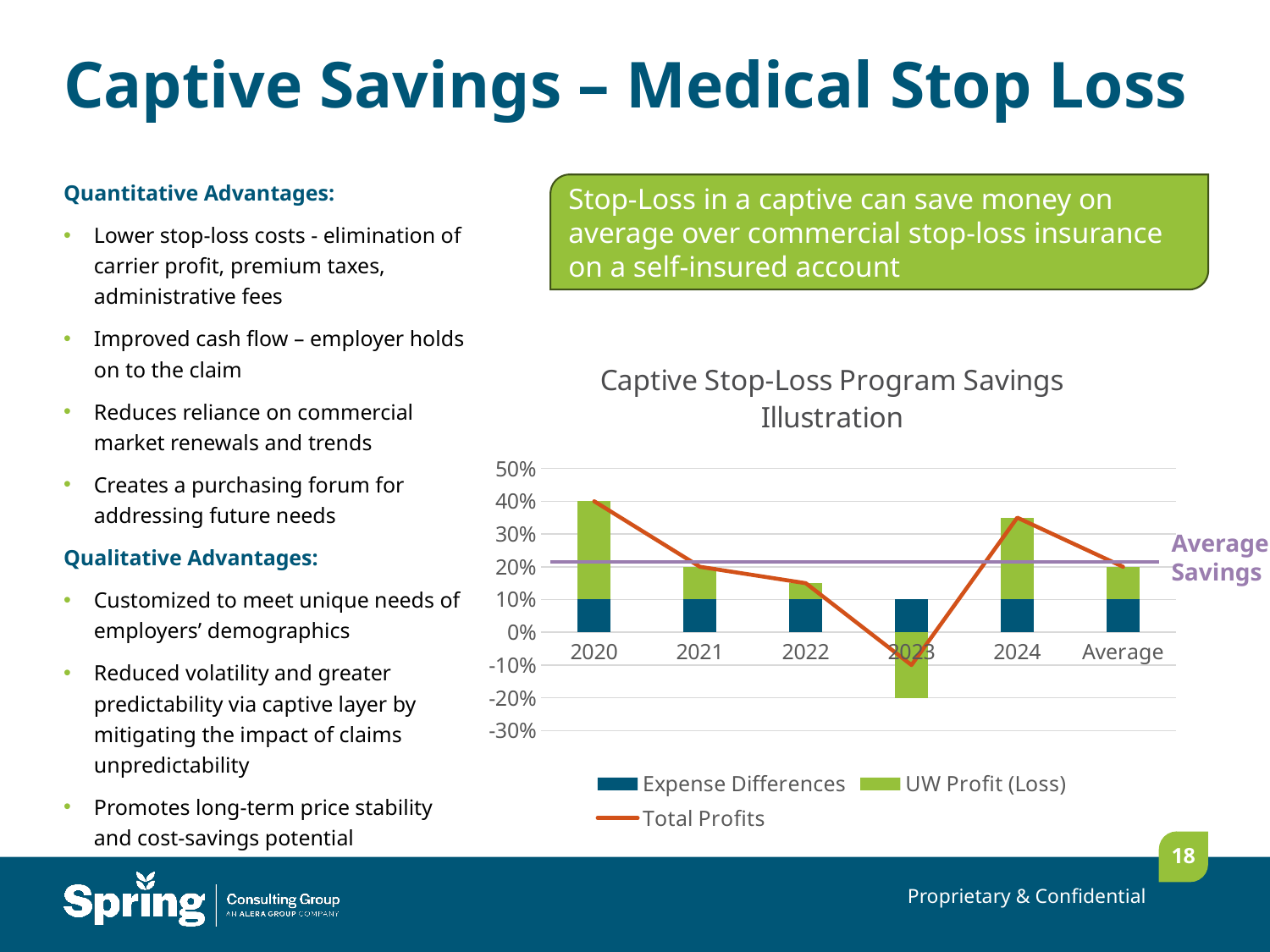
Is the UW Profit (Loss) value for 2023 greater or less than -10%? less Is the Total Profits value for 2023 greater or less than 0%? less In which year is Total Profits lowest in the Captive Stop-Loss Program Savings Illustration chart? 2023 Is the Total Profits value for 2024 greater or less than 30%? greater Which year has the larger Total Profits value, 2021 or 2022? 2021 What kind of chart is the Captive Stop-Loss Program Savings Illustration? A stacked bar chart with a line What is the Expense Differences value for 2020 in the Captive Stop-Loss Program Savings Illustration chart? 10% How many categories are shown on the x axis of the Captive Stop-Loss Program Savings Illustration chart? 6 In which year is Total Profits highest in the Captive Stop-Loss Program Savings Illustration chart? 2020 Does the Total Profits line rise or fall from 2020 to 2023? Fall How many series does the legend of the Captive Stop-Loss Program Savings Illustration chart list? 3 What does the purple horizontal line on the chart represent? Average Savings